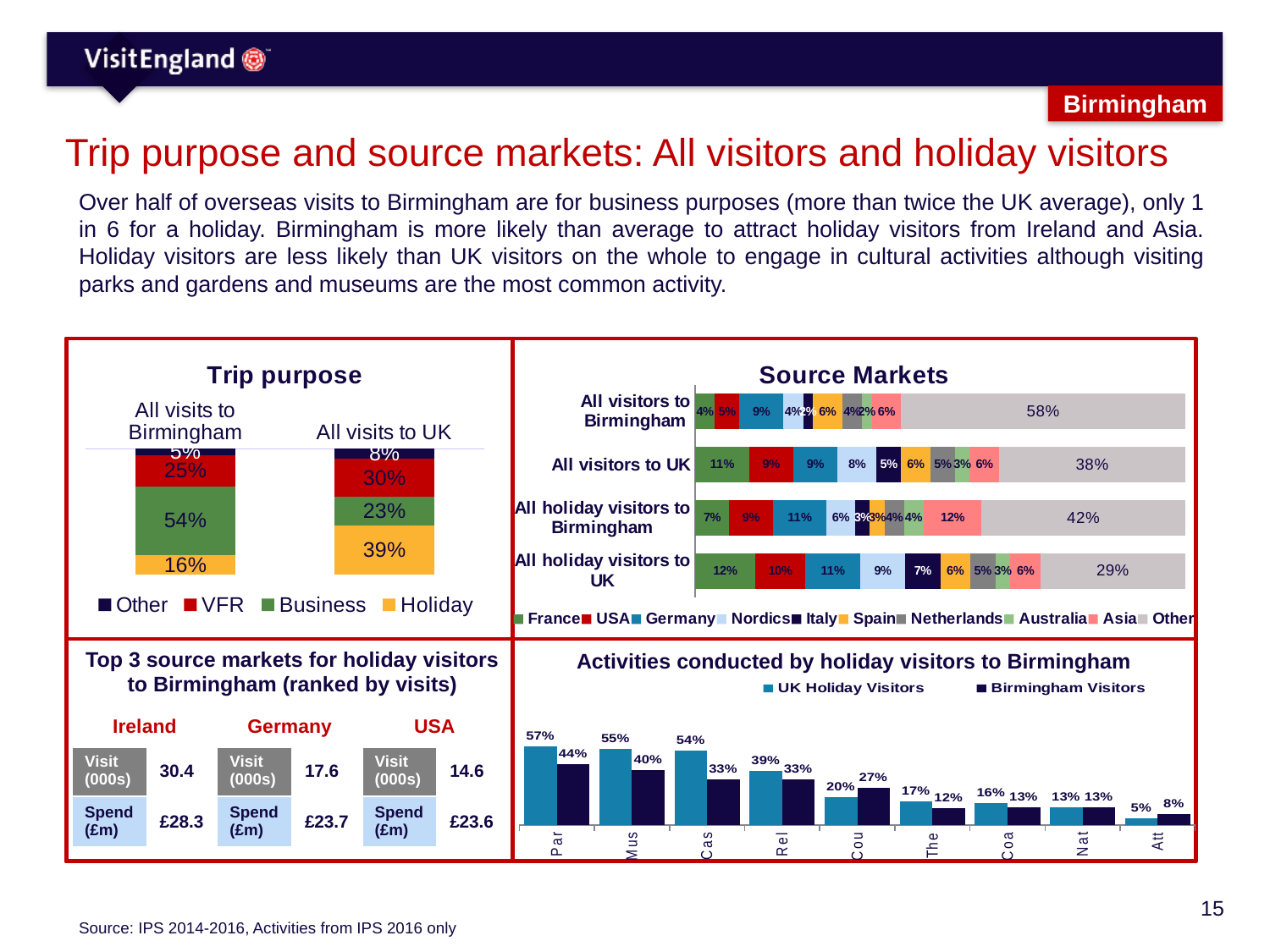
In the Trip purpose chart, which is larger: the VFR share for all visits to Birmingham or for all visits to the UK? All visits to UK In the Trip purpose chart, what is the difference between the Holiday share for all visits to the UK and for all visits to Birmingham? 23 percentage points In the Source Markets chart, which bar has the largest 'Other' share? All visitors to Birmingham In the Activities chart, what is the highest value shown for UK Holiday Visitors? 57% In the Trip purpose chart, what share of all visits to the UK are for a holiday? 39% How many series does the legend of the Source Markets chart list? 10 In the Source Markets chart, what share of all visitors to Birmingham come from the 'Other' markets? 58% How many series does the legend of the Trip purpose chart list? 4 How many activity categories are shown in the Activities conducted by holiday visitors to Birmingham chart? 9 In the Source Markets chart, what share of all holiday visitors to Birmingham come from Asia? 12% In the Trip purpose chart, what share of all visits to Birmingham are for business? 54% What kind of chart is the 'Activities conducted by holiday visitors to Birmingham' chart? Bar chart